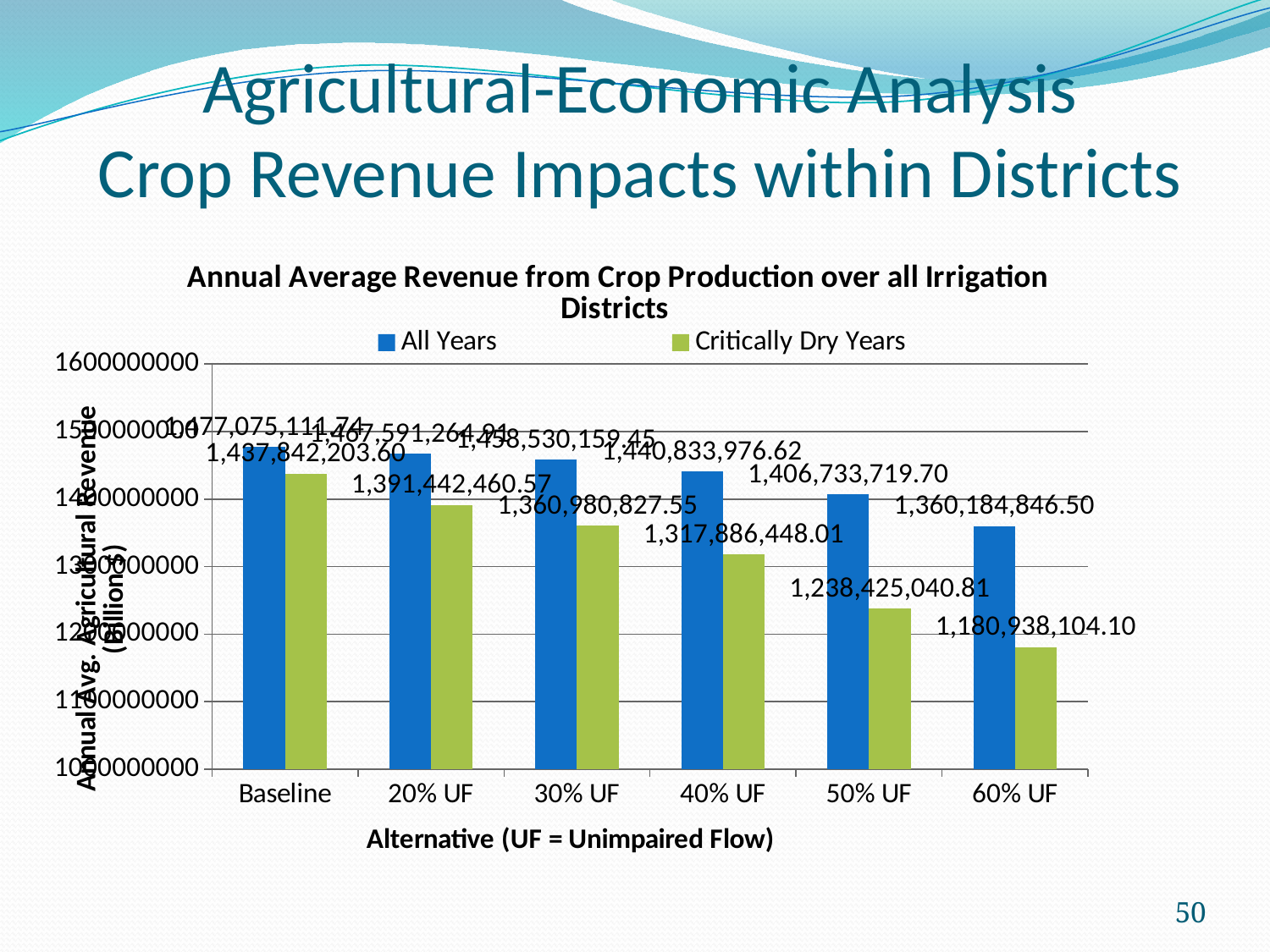
What is the difference between the All Years and Critically Dry Years values for 60% UF? 179,246,742.40 Is the All Years value for Baseline greater or less than 1400000000? greater What is the Critically Dry Years value for 40% UF? 1,317,886,448.01 Which alternative has the highest Critically Dry Years revenue? Baseline What is the Critically Dry Years value for 60% UF? 1,180,938,104.10 Do the Critically Dry Years values rise or fall from Baseline to 60% UF? Fall How many alternatives (categories) are shown on the x axis? 6 What is the All Years value for 50% UF? 1,406,733,719.70 What type of chart is shown on the slide? Bar chart What is the All Years value for 60% UF? 1,360,184,846.50 How many series does the legend list? 2 Which alternative has the lowest Critically Dry Years revenue? 60% UF